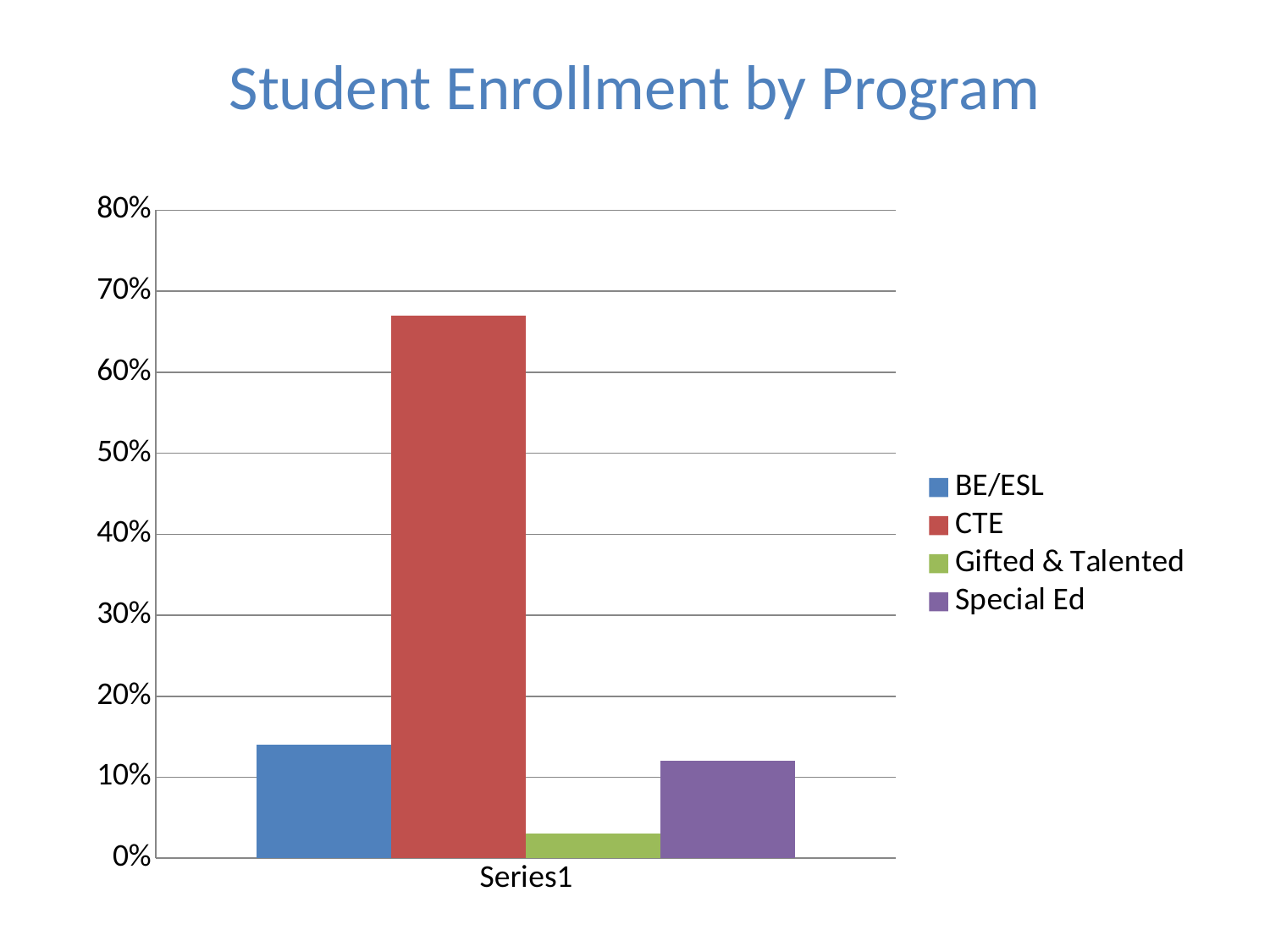
Is the value for CTE greater or less than 70%? less Is the value for BE/ESL greater or less than 10%? greater How many series does the legend list? 4 Which is larger, the value for CTE or the value for BE/ESL? CTE Which program has the lowest enrollment bar? Gifted & Talented Is the value for Special Ed greater or less than 20%? less Which program has the highest enrollment bar? CTE What is the title of the chart? Student Enrollment by Program Which is larger, the value for Special Ed or the value for Gifted & Talented? Special Ed What kind of chart is shown on the slide? bar chart